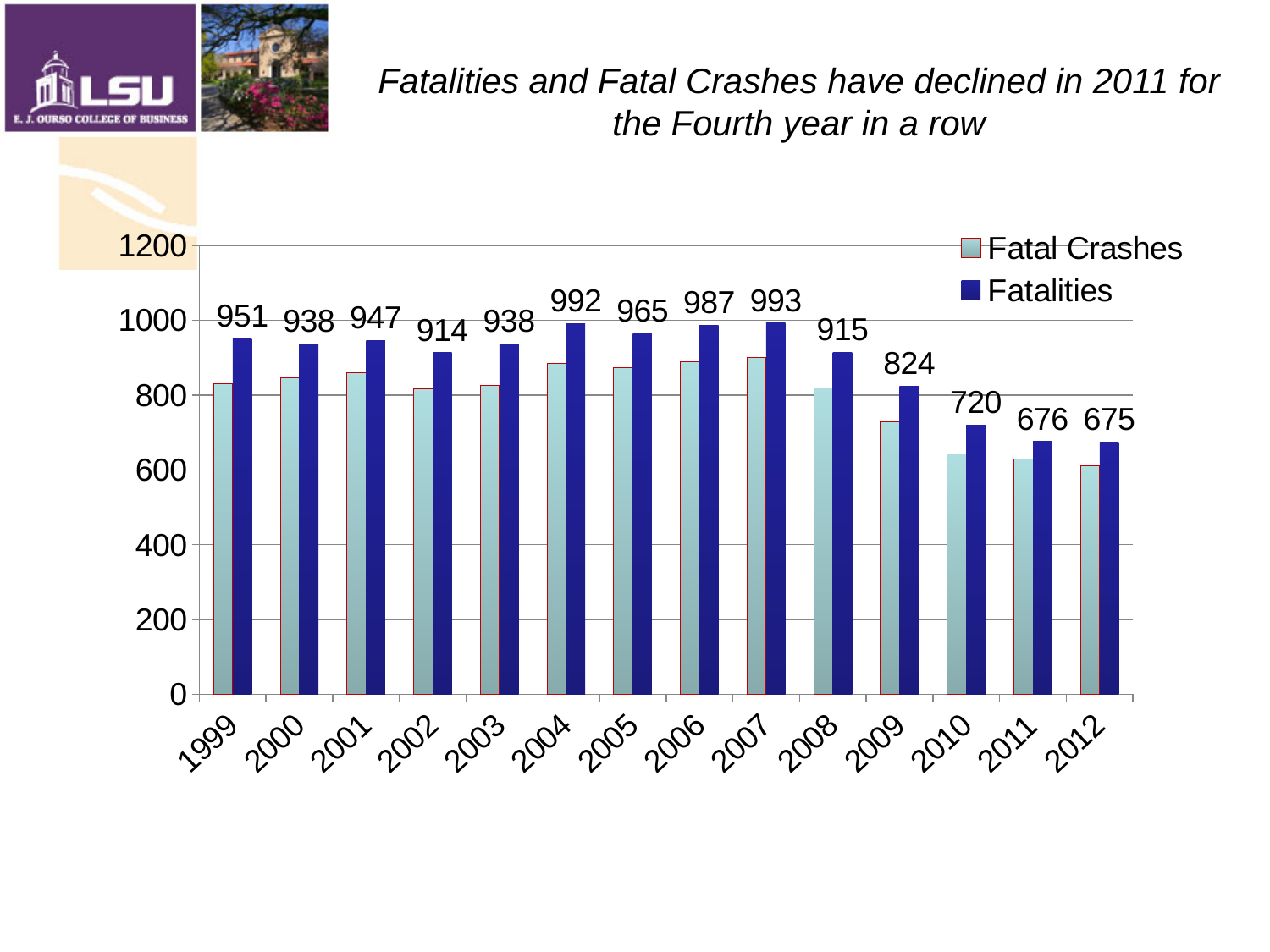
Is the Fatal Crashes value for 2007 greater or less than 800? greater How many series does the legend list? 2 Which year has the lowest Fatalities value? 2012 What is the difference between the Fatalities values for 2007 and 2012? 318 What is the Fatalities value for 2010? 720 Do the Fatalities values rise or fall from 2007 to 2012? fall Is the Fatal Crashes value for 2012 greater or less than 800? less Which is larger, the Fatalities value for 2004 or for 2005? 2004 What is the Fatalities value for 2007? 993 Which year has the highest Fatalities value? 2007 How many years are shown on the x axis? 14 What is the Fatalities value for 1999? 951